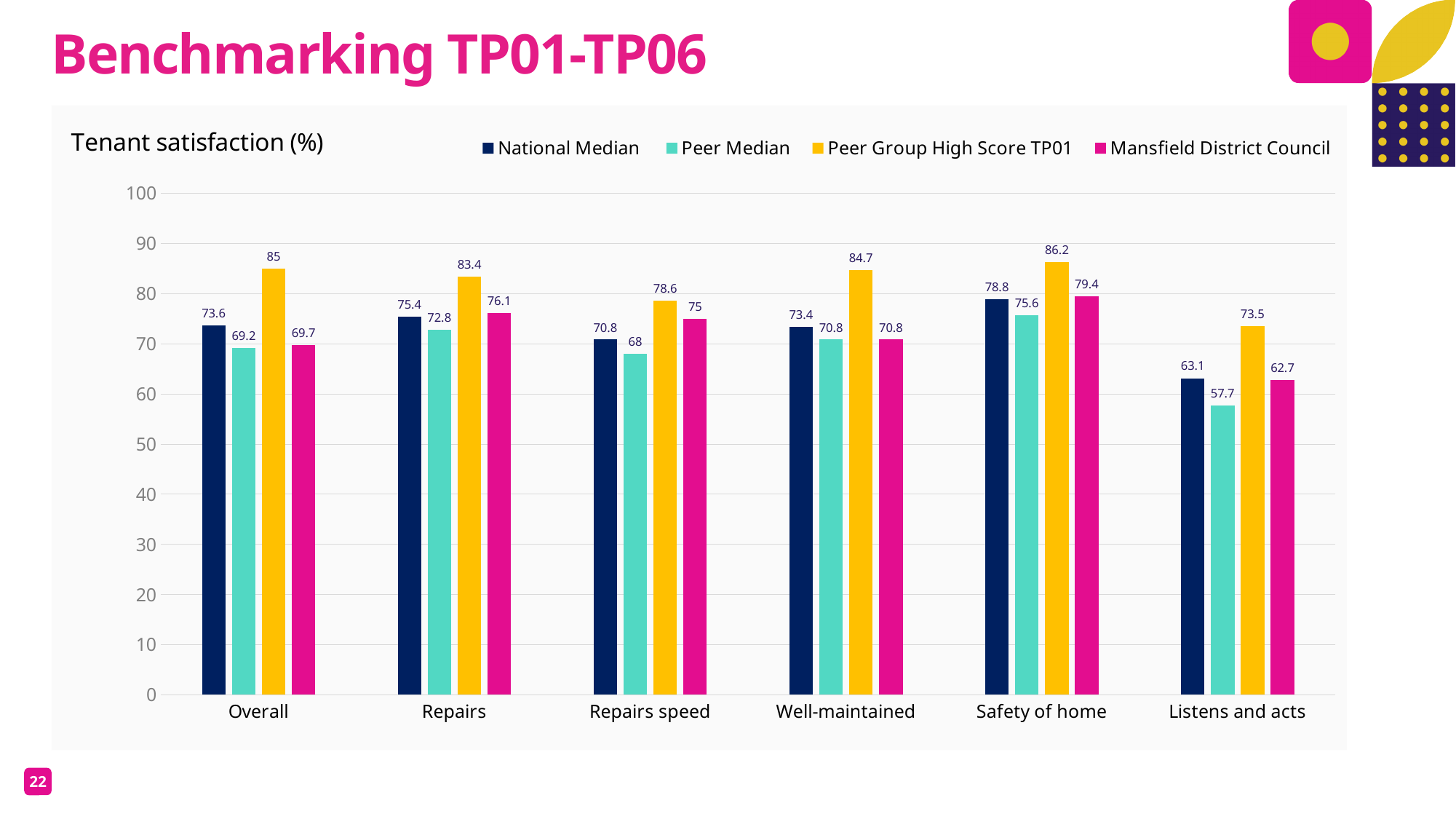
What is the difference between the Peer Group High Score TP01 and the Mansfield District Council values for Overall? 15.3 Which category has the highest Peer Group High Score TP01 value? Safety of home How many series does the legend list? 4 What is the Peer Median value for Listens and acts? 57.7 What kind of chart is shown on the slide? Bar chart What is the National Median value for Repairs speed? 70.8 Which colour represents Mansfield District Council in the legend? Pink What is the Mansfield District Council value for Safety of home? 79.4 What is the title of the chart? Tenant satisfaction (%) How many categories are shown on the x axis? 6 Which category has the lowest Mansfield District Council value? Listens and acts Which is larger for Repairs: the National Median or the Mansfield District Council value? Mansfield District Council